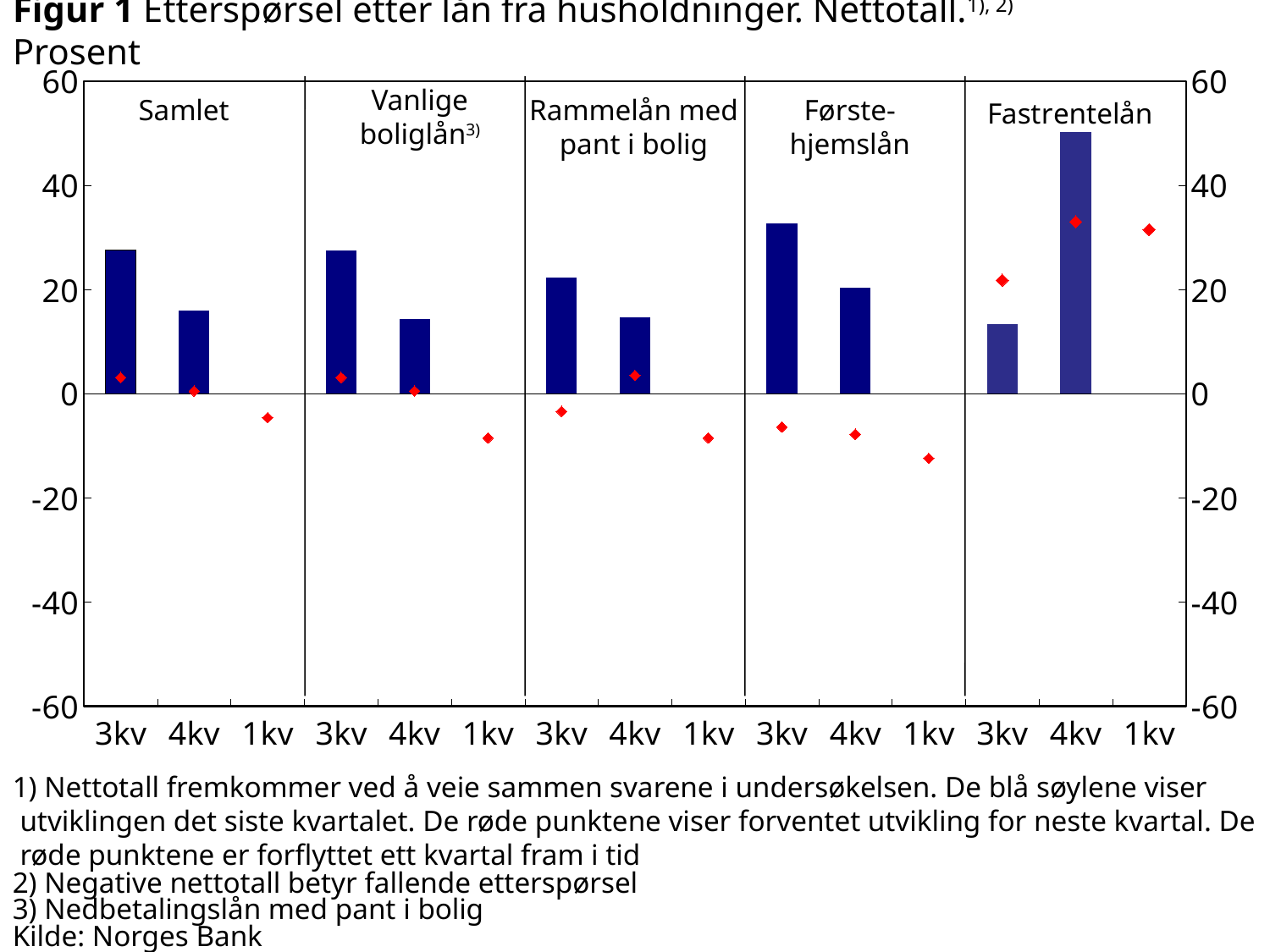
In the Fastrentelån panel, do the bars rise or fall from 3kv to 4kv? rise Is the 3kv bar for Førstehjemslån greater or less than 40? less Which panel has the lowest 3kv bar? Fastrentelån Is the 4kv bar for Rammelån med pant i bolig greater or less than 20? less What source is cited for the chart? Norges Bank Which panel contains the tallest bar in the chart? Fastrentelån In the Samlet panel, which bar is taller, 3kv or 4kv? 3kv Is the 3kv bar for Samlet greater or less than 20? greater How many loan categories (panels) are shown in the chart? 5 What kind of chart is shown on the slide? bar chart